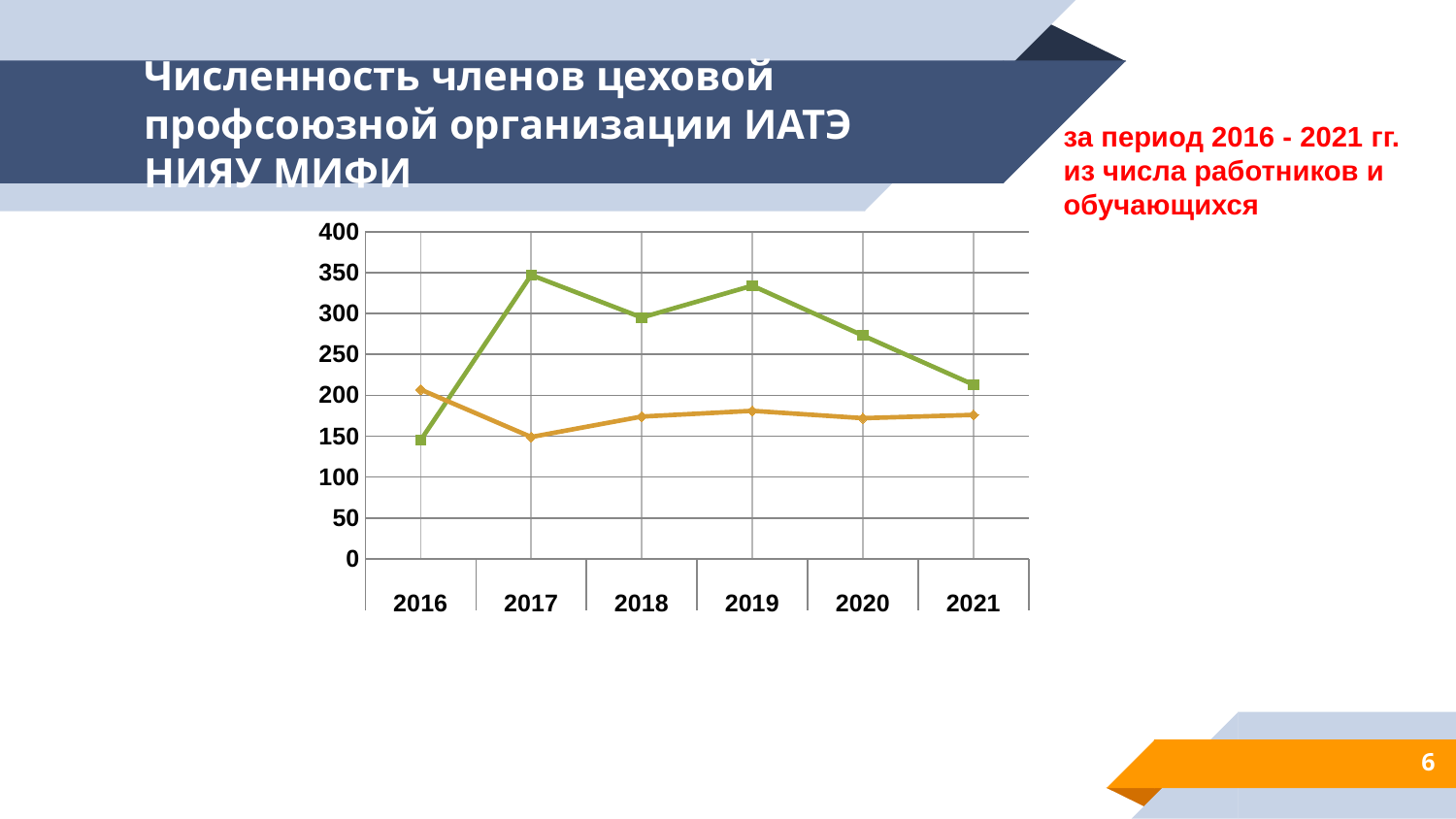
What kind of chart is shown on the slide? line chart Is the value of the green line in 2017 greater or less than 300? greater Is the value of the orange line in 2019 greater or less than 200? less Does the green line rise or fall from 2019 to 2021? fall In 2016, which line has the higher value, the green line or the orange line? the orange line How many lines (series) are plotted on the chart? 2 Is the value of the green line in 2020 greater or less than 250? greater Which year has the lowest value on the green line? 2016 Which year has the lowest value on the orange line? 2017 Which year has the highest value on the orange line? 2016 How many years are shown on the x axis of the chart? 6